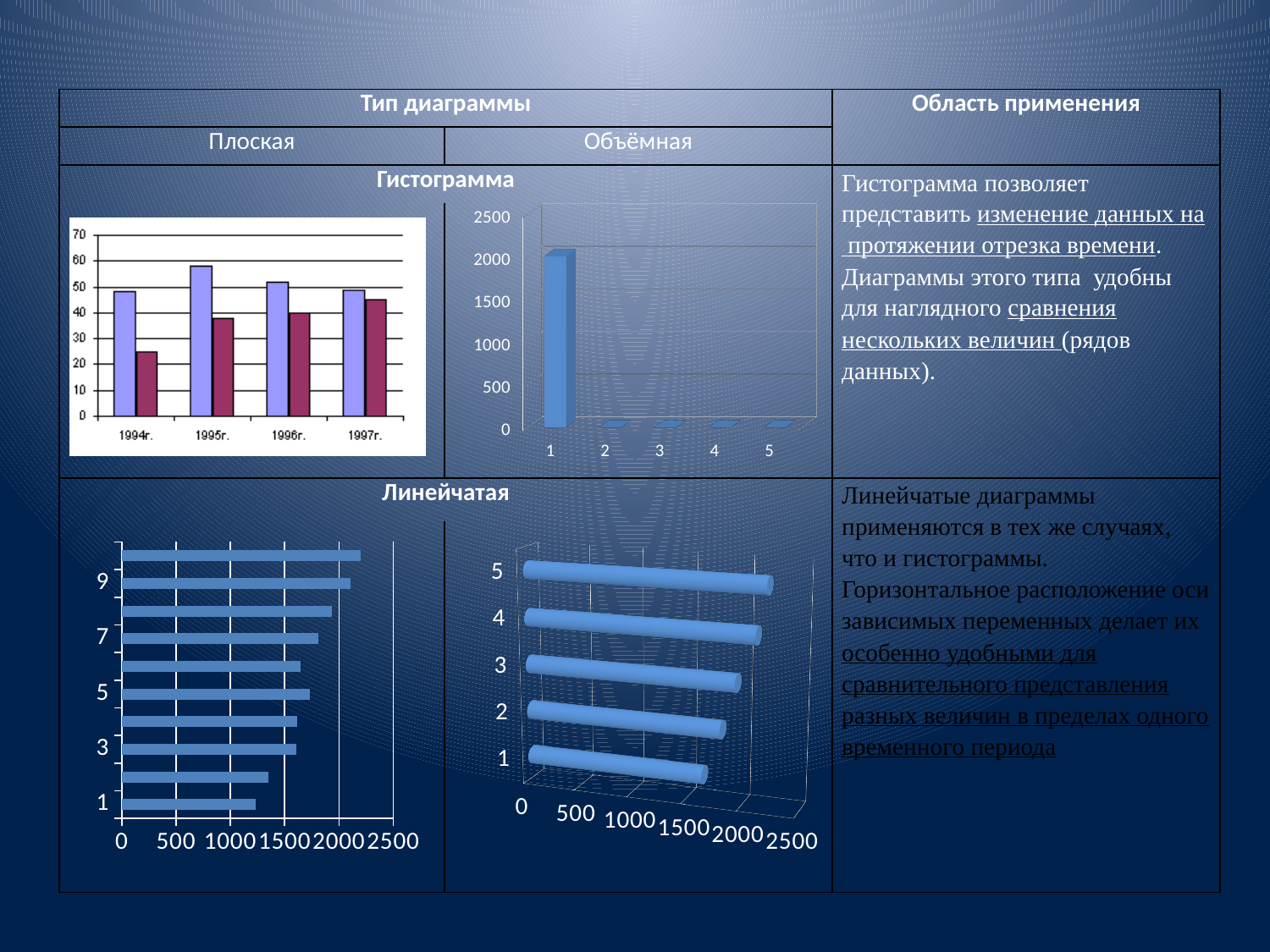
In the top-left chart, which category has the tallest light-blue bar? 1995г. In the top-left chart, is the light-blue bar for 1995г. greater or less than 50? greater What kind of chart is the top-left chart (under 'Плоская', 'Гистограмма')? bar chart In the bottom-left chart, is the value for category 1 greater or less than 1500? less In the top-left chart, which category has the shortest purple bar? 1994г. In the top-left chart, is the purple bar for 1994г. greater or less than 30? less How many bars are plotted in the bottom-left horizontal bar chart? 10 How many categories are shown on the x axis of the top-left chart? 4 In the bottom-right 3D chart, which category has the longest bar? 5 In the top-right 3D chart, which category has the highest bar? 1 How many categories are on the x axis of the top-right 3D chart? 5